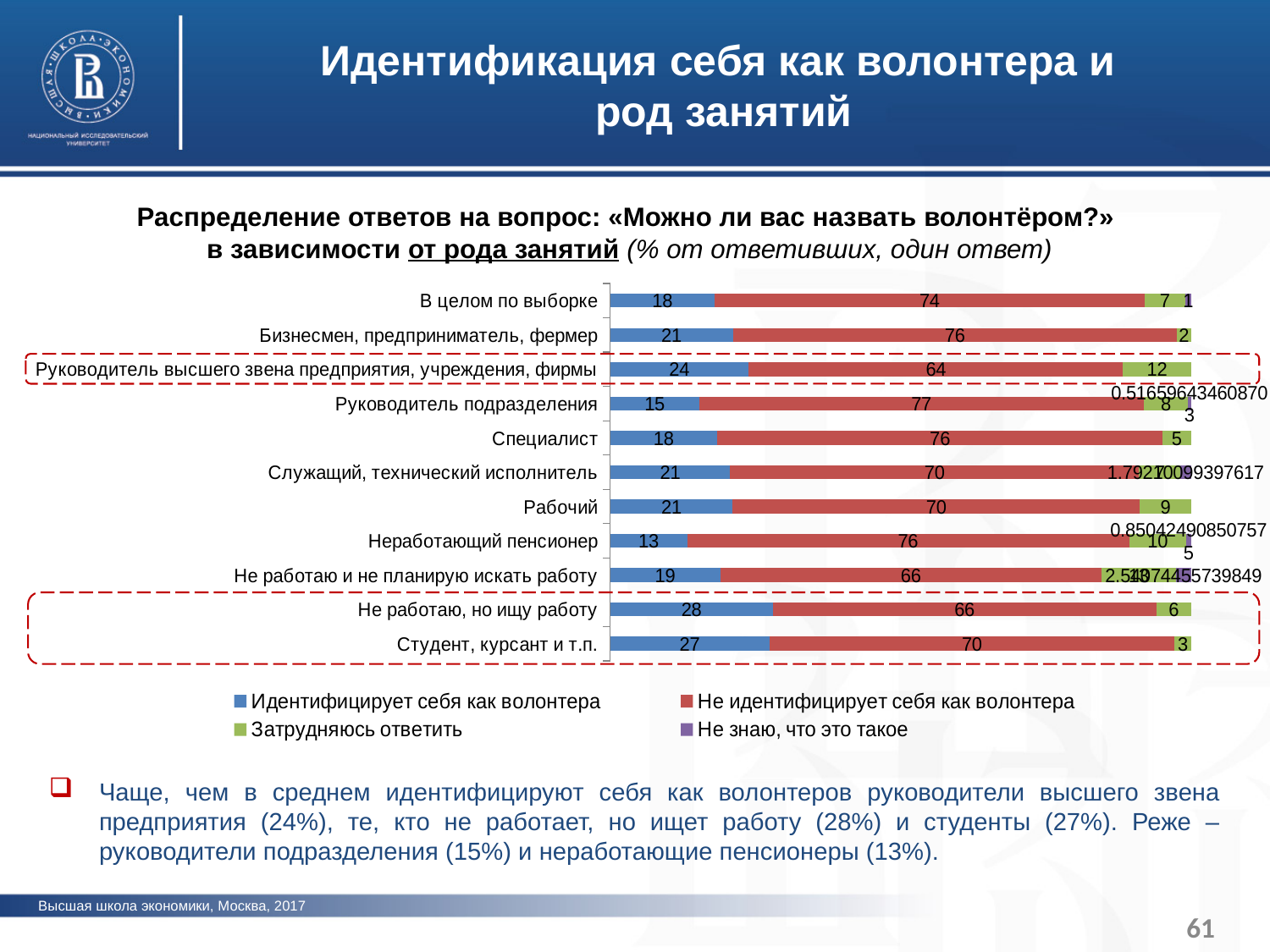
Which category has the highest value for «Идентифицирует себя как волонтера»? Не работаю, но ищу работу Which category has the lowest value for «Идентифицирует себя как волонтера»? Неработающий пенсионер What is the value of «Затрудняюсь ответить» for «Руководитель высшего звена предприятия, учреждения, фирмы»? 12 What is the value of «Не идентифицирует себя как волонтера» for «В целом по выборке»? 74 How many series does the legend list? 4 What is the value of «Не идентифицирует себя как волонтера» for «Руководитель подразделения»? 77 Which category has the highest value for «Не идентифицирует себя как волонтера»? Руководитель подразделения How many occupation categories are plotted on the chart? 11 Which has a larger «Идентифицирует себя как волонтера» value: «Бизнесмен, предприниматель, фермер» or «Специалист»? Бизнесмен, предприниматель, фермер What is the value of «Идентифицирует себя как волонтера» for «Студент, курсант и т.п.»? 27 What type of chart is shown on the slide? bar chart What is the difference between the «Идентифицирует себя как волонтера» values for «Не работаю, но ищу работу» and «Неработающий пенсионер»? 15